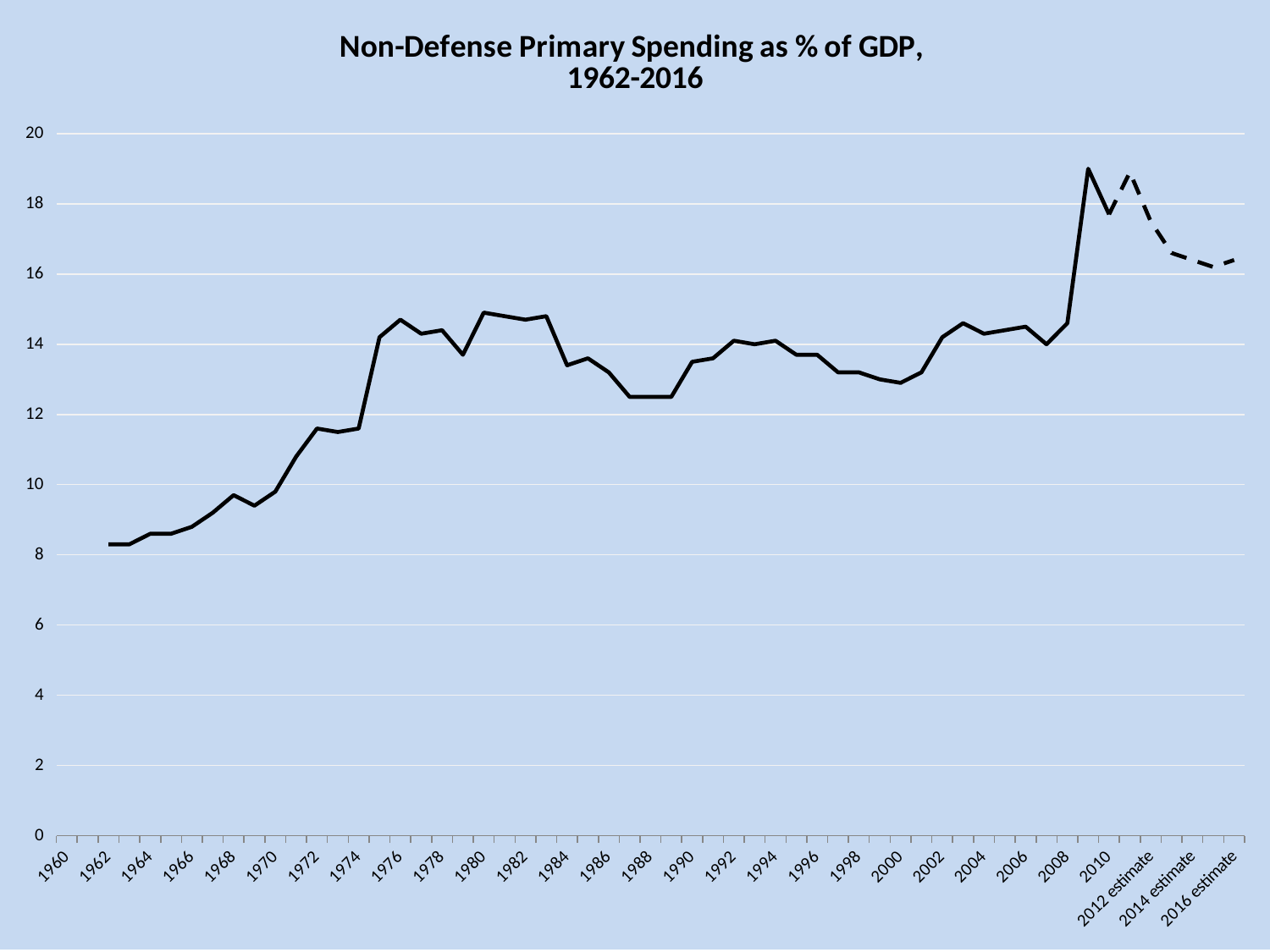
Is the value for 1962 greater or less than 10? less Is the value for 2010 greater or less than 16? greater What is the title of the chart? Non-Defense Primary Spending as % of GDP, 1962-2016 Does the line rise or fall between 1962 and 1976? rise Between which two labeled years on the x axis does the line reach its highest point? 2008 and 2010 Is the value for 2000 greater or less than 14? less Does the line rise or fall between 2010 and the 2016 estimate? fall What kind of chart is shown on the slide? line chart